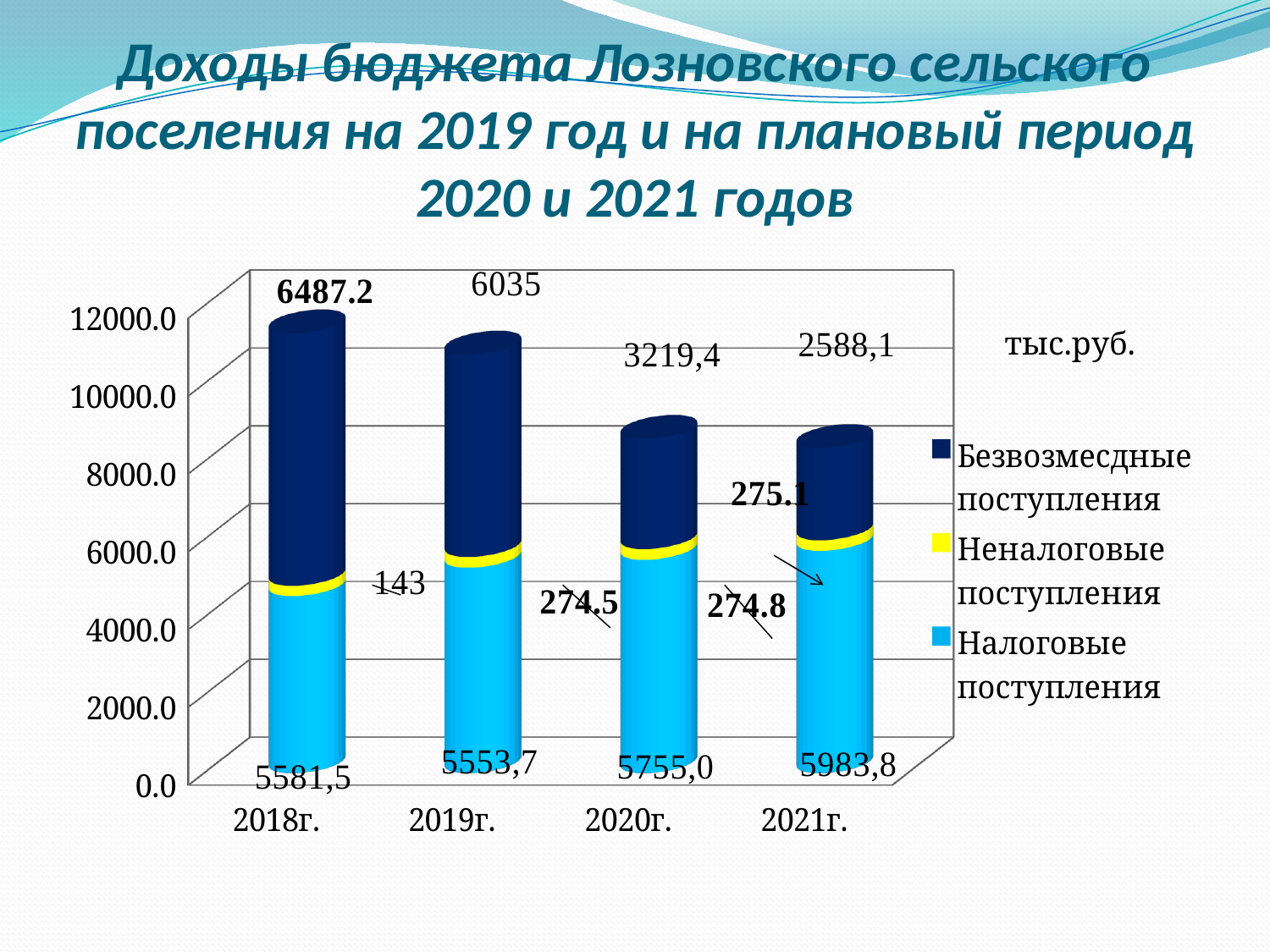
What is the value of Налоговые поступления for 2021г.? 5983,8 What is the difference between Налоговые поступления in 2021г. and 2020г.? 228,8 Which year has the larger value of Безвозмездные поступления, 2019г. or 2020г.? 2019г. What is the value of Безвозмездные поступления for 2020г.? 3219,4 What unit is indicated next to the chart? тыс.руб. What is the value of Безвозмездные поступления for 2018г.? 6487.2 What kind of chart is shown on the slide? bar chart How many series does the legend list? 3 Do the values of Безвозмездные поступления rise or fall from 2018г. to 2021г.? fall How many years are shown along the x axis? 4 In which year is Безвозмездные поступления the highest? 2018г.